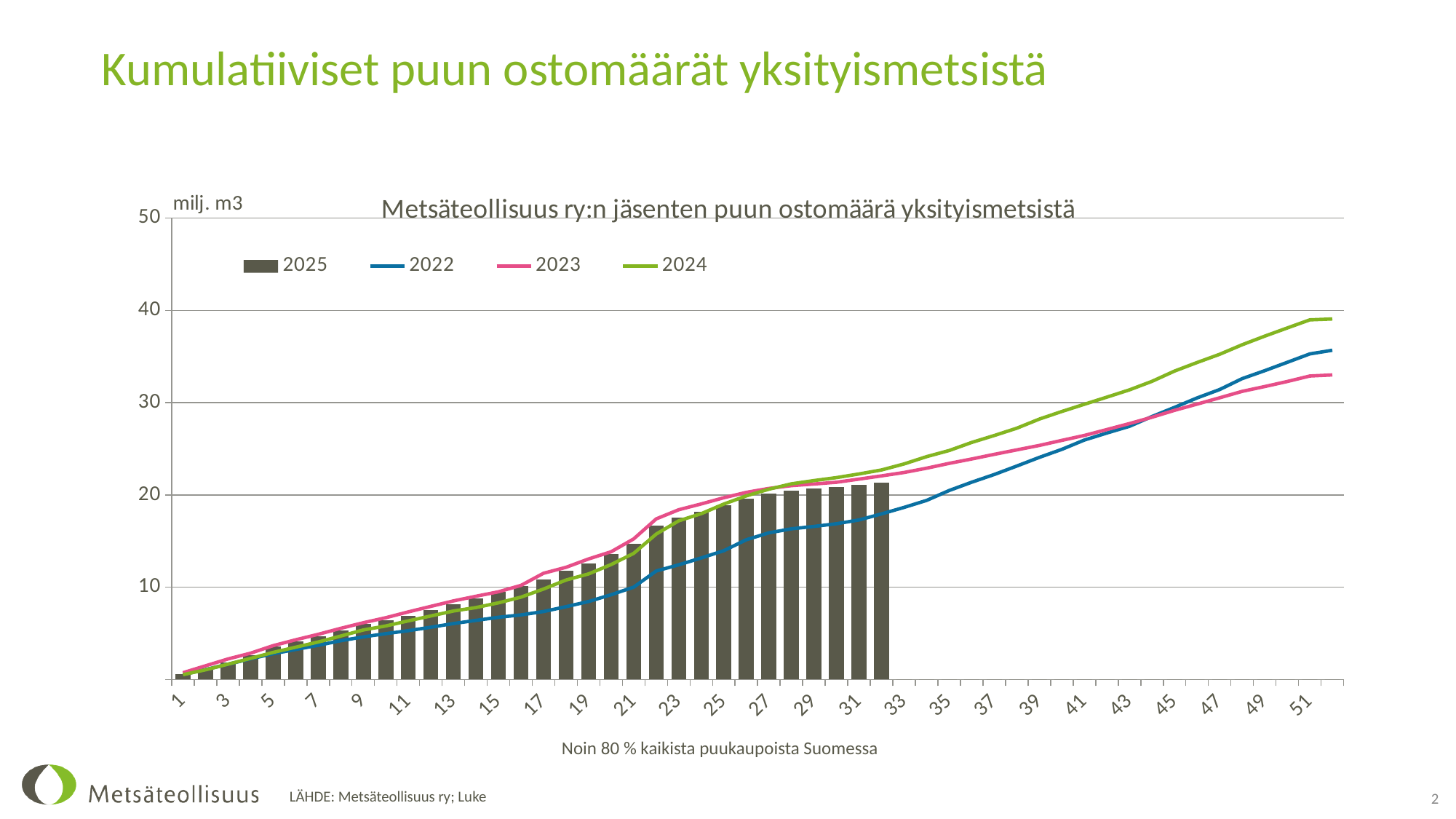
At week 33, which is larger, the value for 2022 or the value for 2023? 2023 What is the title of the chart? Metsäteollisuus ry:n jäsenten puun ostomäärä yksityismetsistä Which series has the highest value at week 51? 2024 At week 33, is the value for 2022 greater or less than 20? less At week 51, is the value for 2024 greater or less than 30? greater How many series does the legend list? 4 At week 21, is the value for 2025 greater or less than 10? greater Which series is shown as bars rather than lines? 2025 Which series has the lowest value at week 51? 2023 What kind of chart is this? Combination of a bar chart and line chart Do the values for the 2024 series rise or fall along the x axis? rise